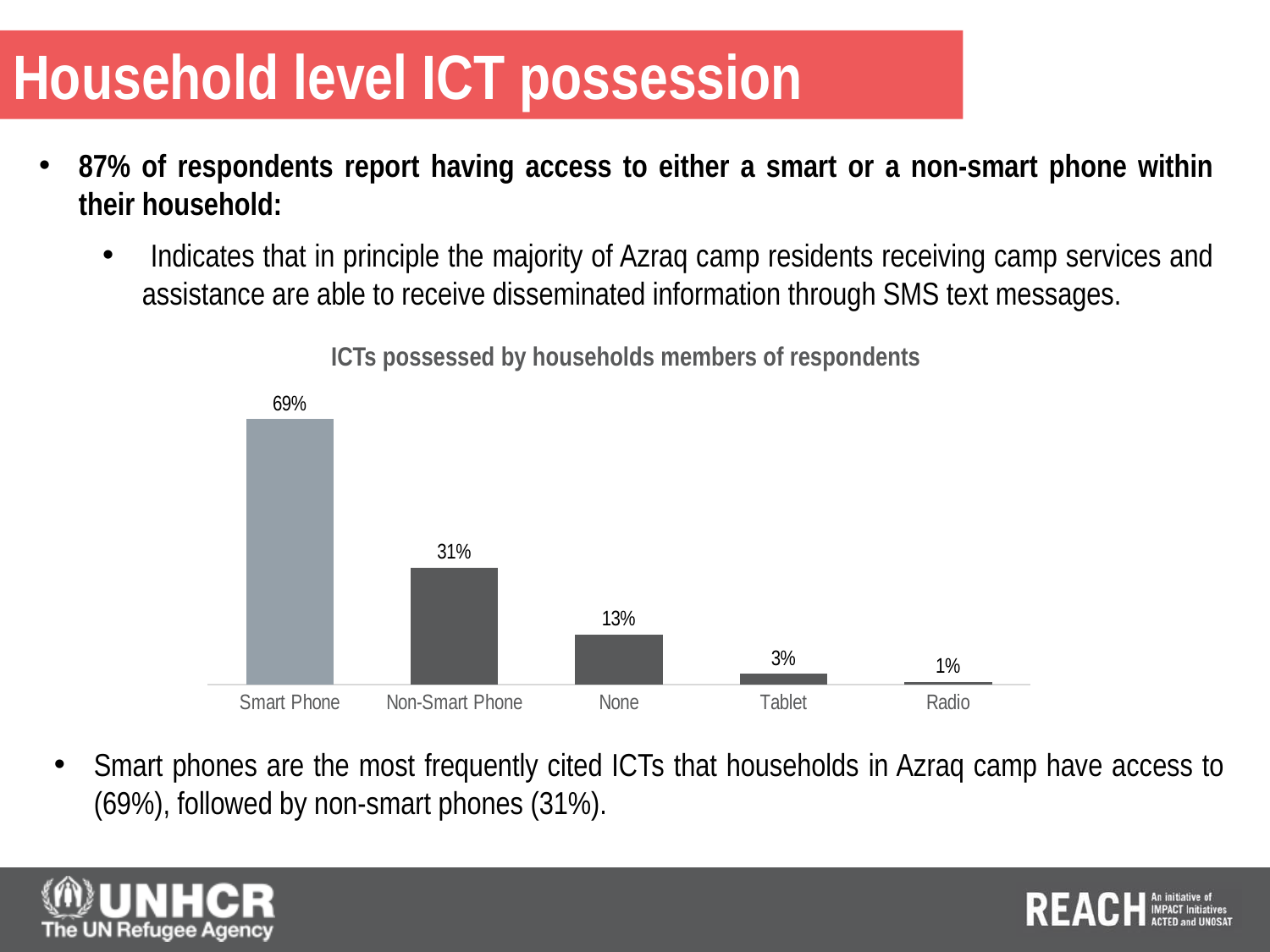
What is the value shown for Non-Smart Phone? 31% What is the value for Tablet? 3% What is the title of the chart? ICTs possessed by households members of respondents Which category has the highest value in the chart? Smart Phone What percentage is shown for the None category? 13% What percentage of respondents' households possess a smart phone? 69% How many categories are shown in the chart? 5 Which category has the lowest value in the chart? Radio What is the difference between the None and Tablet values? 10% What is the difference between the Smart Phone and Non-Smart Phone values? 38% What type of chart is shown on the slide? Bar chart Which is larger, the value for Tablet or the value for Radio? Tablet